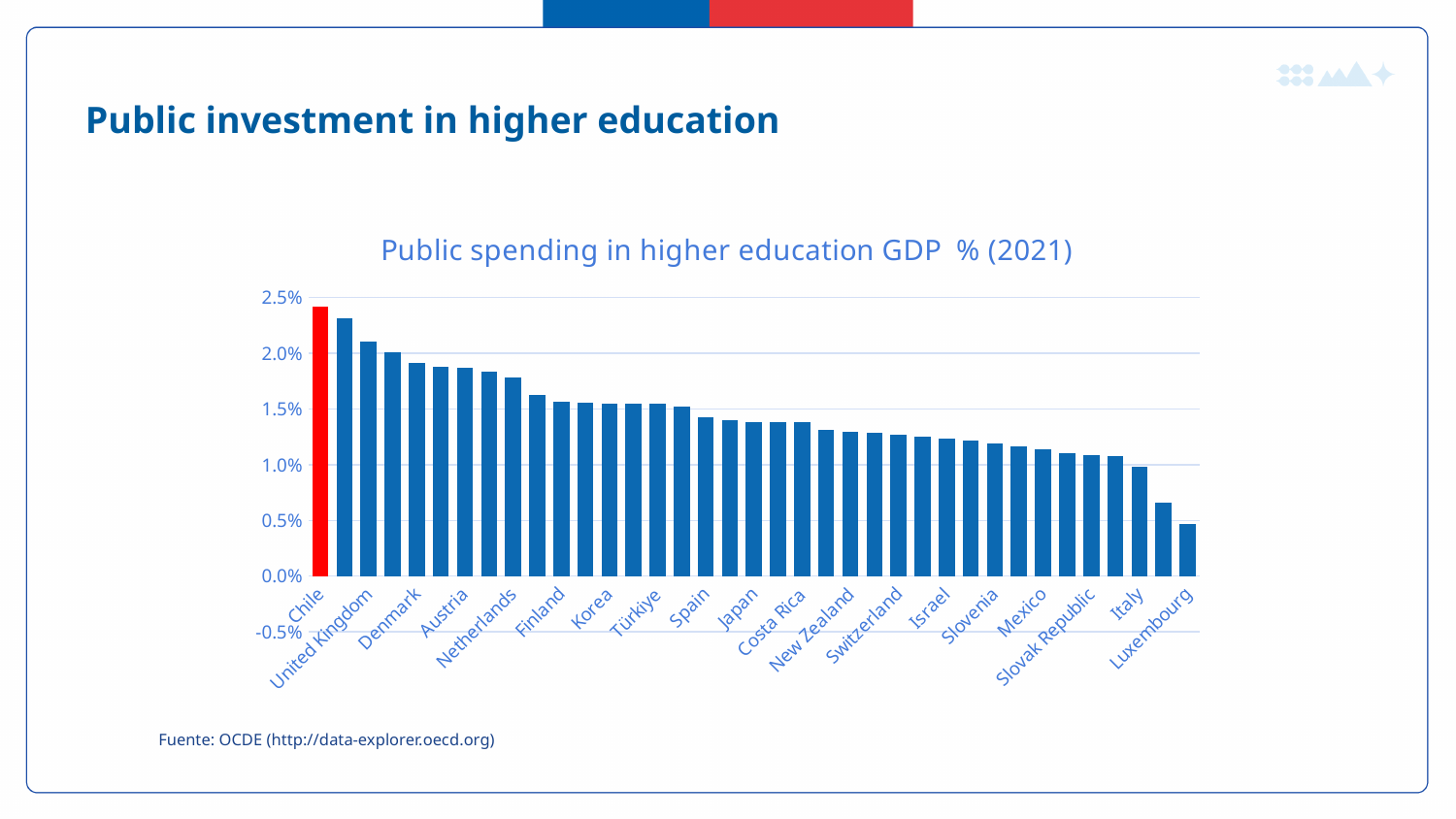
Is the value for Luxembourg greater or less than 1.0%? less Which country has the highest public spending in higher education as a % of GDP? Chile Which country has the lowest public spending in higher education as a % of GDP? Luxembourg Is the value for Israel greater or less than 1.0%? greater Which country's bar is coloured red? Chile Is the value for Austria greater or less than 2.0%? less Do the values rise or fall moving from left to right along the x axis? fall Which has a higher value, Chile or Denmark? Chile What kind of chart is shown on the slide? bar chart